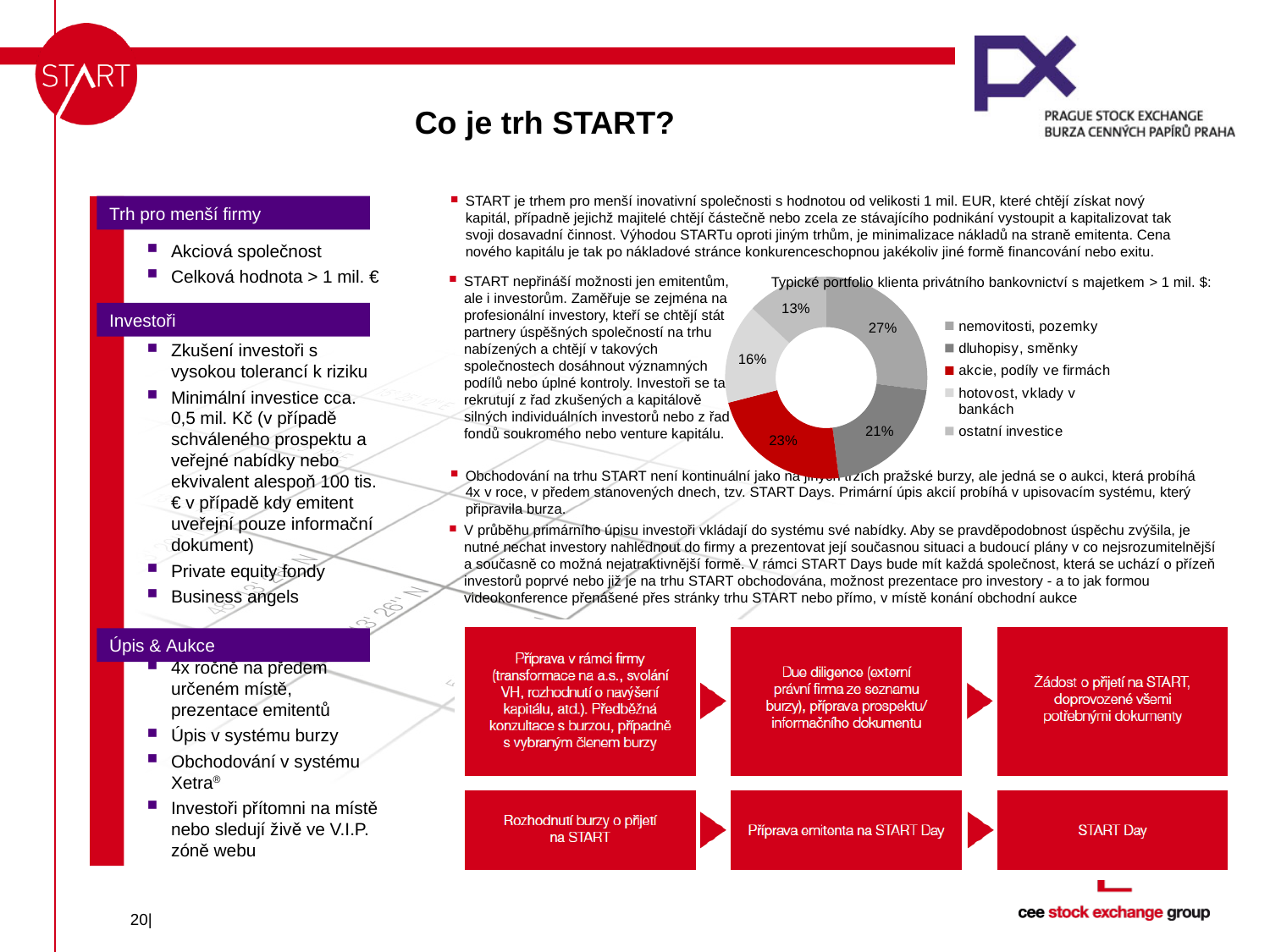
What share of the portfolio is 'hotovost, vklady v bankách'? 16% What is the title of the chart on the slide? Typické portfolio klienta privátního bankovnictví s majetkem > 1 mil. $: Which category has the largest share of the portfolio? nemovitosti, pozemky What share of the portfolio is 'nemovitosti, pozemky'? 27% What share of the portfolio is 'ostatní investice'? 13% Which category has the smallest share of the portfolio? ostatní investice Which is larger: the share for 'akcie, podíly ve firmách' or for 'hotovost, vklady v bankách'? akcie, podíly ve firmách What type of chart is shown on the slide? doughnut (pie) chart How many categories does the chart show? 5 What share of the portfolio is 'dluhopisy, směnky'? 21% What is the difference in percentage points between 'nemovitosti, pozemky' and 'dluhopisy, směnky'? 6 percentage points What share of the portfolio is 'akcie, podíly ve firmách'? 23%